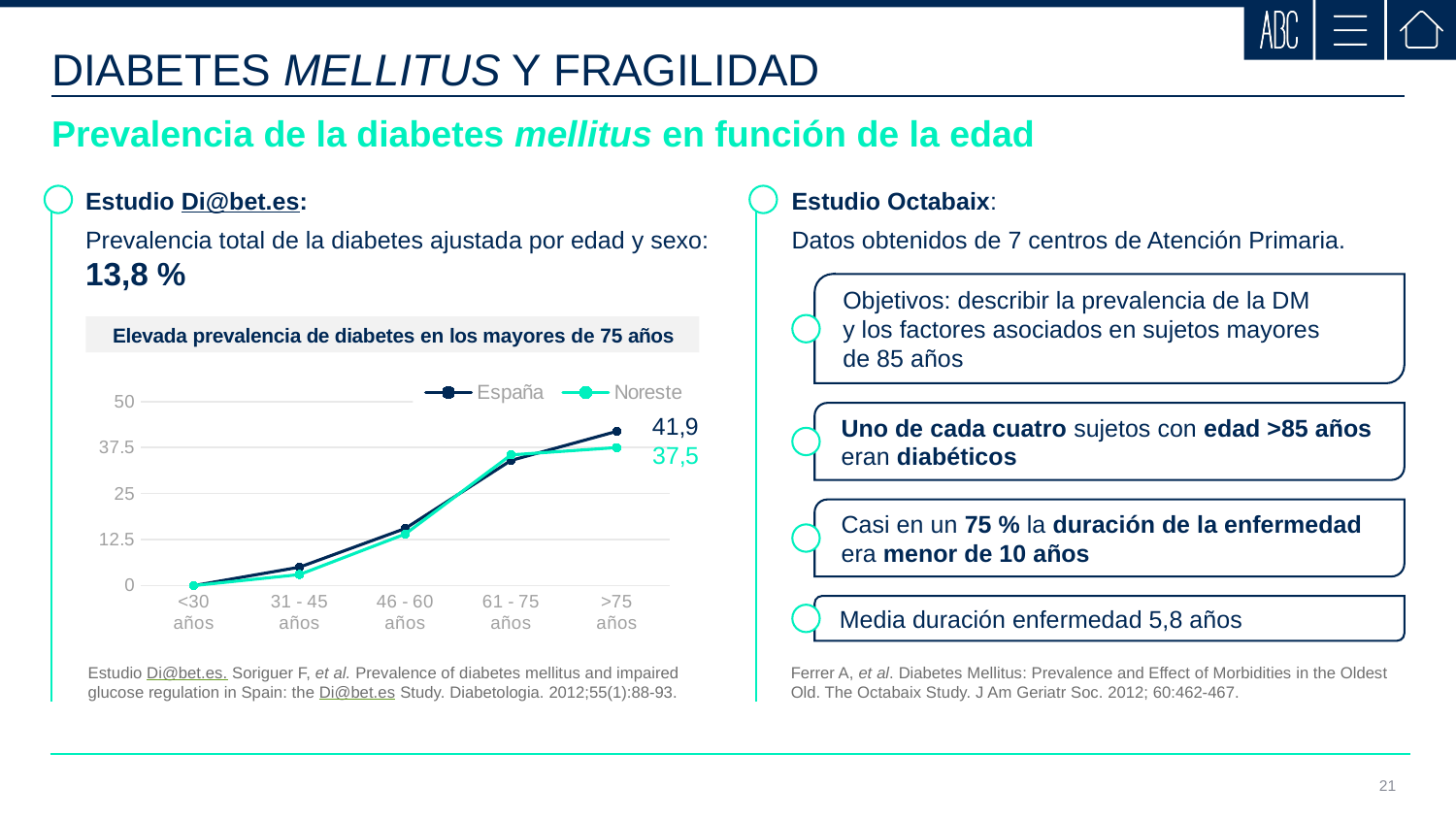
What is the difference between the España and Noreste values in the >75 años category? 4,4 How many series does the chart legend list? 2 Which age category has the highest value for España? >75 años Which age category has the lowest value for Noreste? <30 años Do the values for España rise or fall as age increases along the x axis? rise How many age categories are shown on the x axis of the chart? 5 What is the value for Noreste in the >75 años category? 37,5 Is the value for España in the 46 - 60 años category greater or less than 25? less What type of chart is shown on the slide? Line chart What is the title of the chart? Elevada prevalencia de diabetes en los mayores de 75 años What is the value for España in the >75 años category? 41,9 In the >75 años category, which series has the larger value, España or Noreste? España